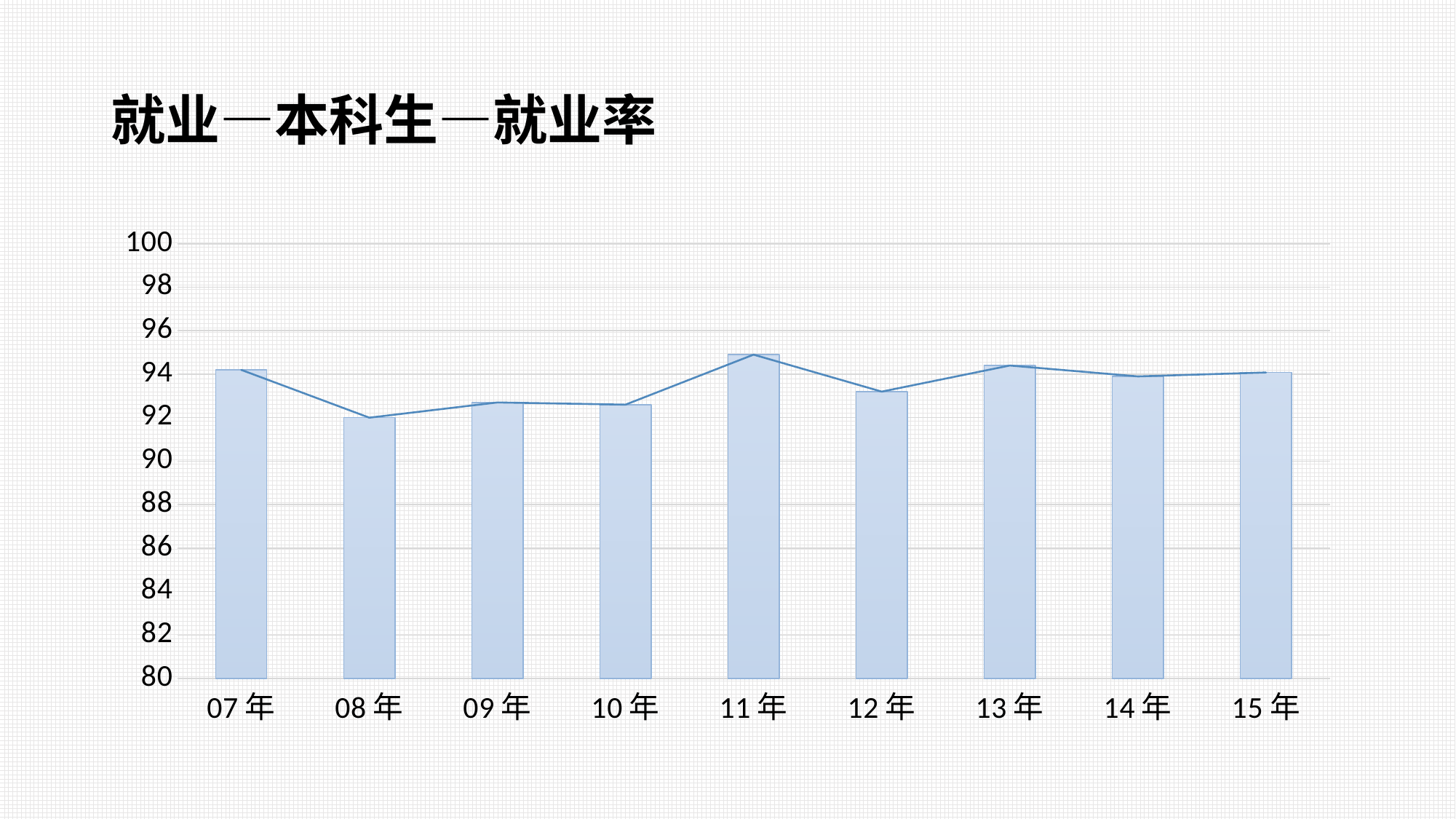
How many years (categories) are shown on the x axis of the chart? 9 What is the title of the slide containing the chart? 就业—本科生—就业率 Which is larger, the value for 11年 or the value for 08年? 11年 Which is larger, the value for 13年 or the value for 10年? 13年 Is the value for 11年 greater or less than 94? greater Is the value for 08年 greater or less than 94? less Does the value rise or fall from 07年 to 08年? fall Is the value for 12年 greater or less than 92? greater What kind of chart is used to show the employment rate by year? combination bar and line chart Which year has the highest bar in the chart? 11年 Which year has the lowest bar in the chart? 08年